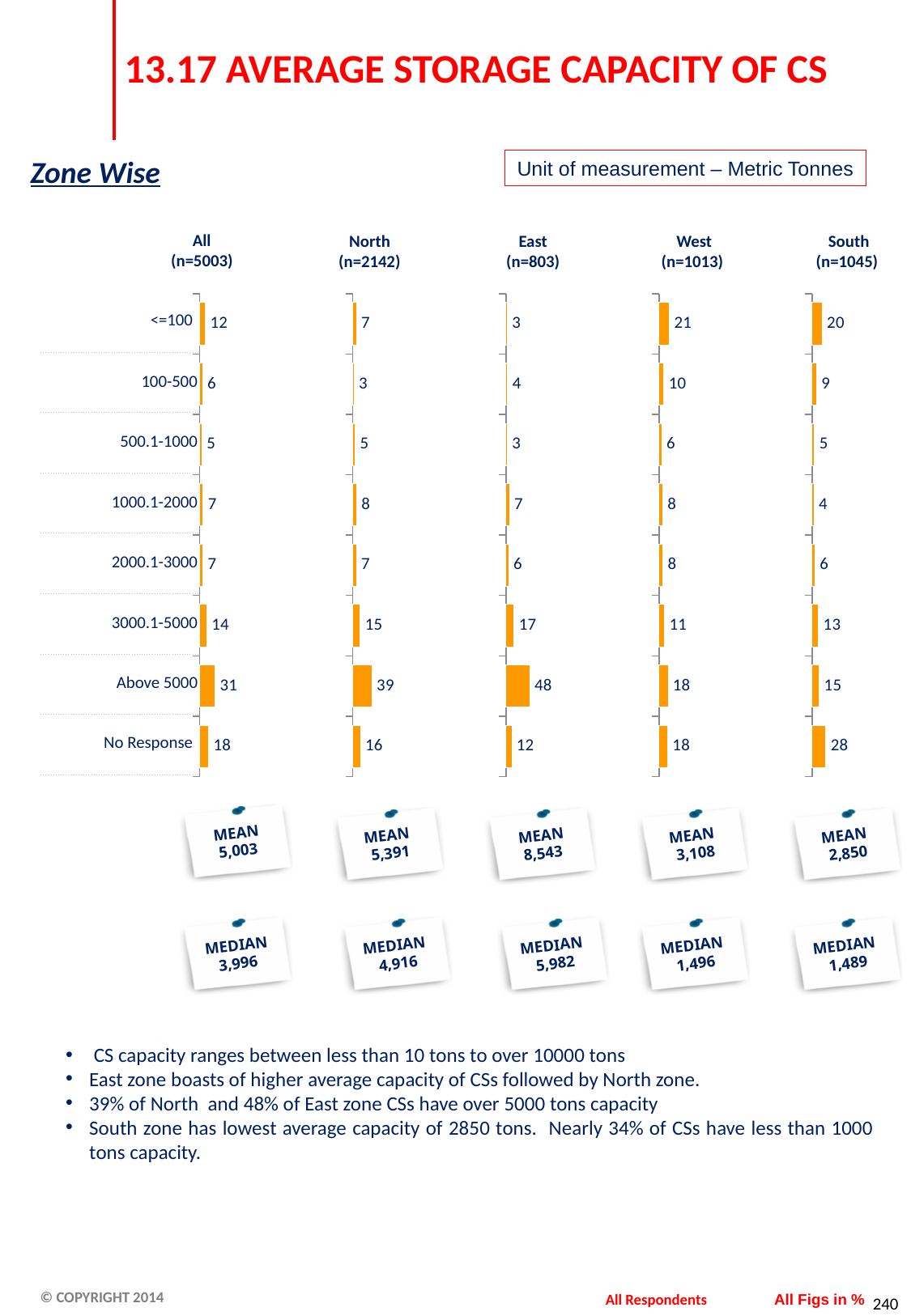
Comparing the Above 5000 values, how much higher is the East (n=803) chart than the North (n=2142) chart? 9 In the North (n=2142) chart, which category has the highest value? Above 5000 In the North (n=2142) chart, which category has the lowest value? 100-500 In the South (n=1045) chart, which category has the highest value? No Response In the West (n=1013) chart, what is the value for <=100? 21 In the East (n=803) chart, what is the value for Above 5000? 48 In the West (n=1013) chart, which is larger: the value for <=100 or the value for Above 5000? <=100 In the All (n=5003) chart, what is the difference between the values for Above 5000 and No Response? 13 What unit of measurement is stated for the charts on the slide? Metric Tonnes How many categories are shown in the All (n=5003) chart? 8 In the South (n=1045) chart, what is the value for 3000.1-5000? 13 What type of chart is used for the North (n=2142) data? Bar chart